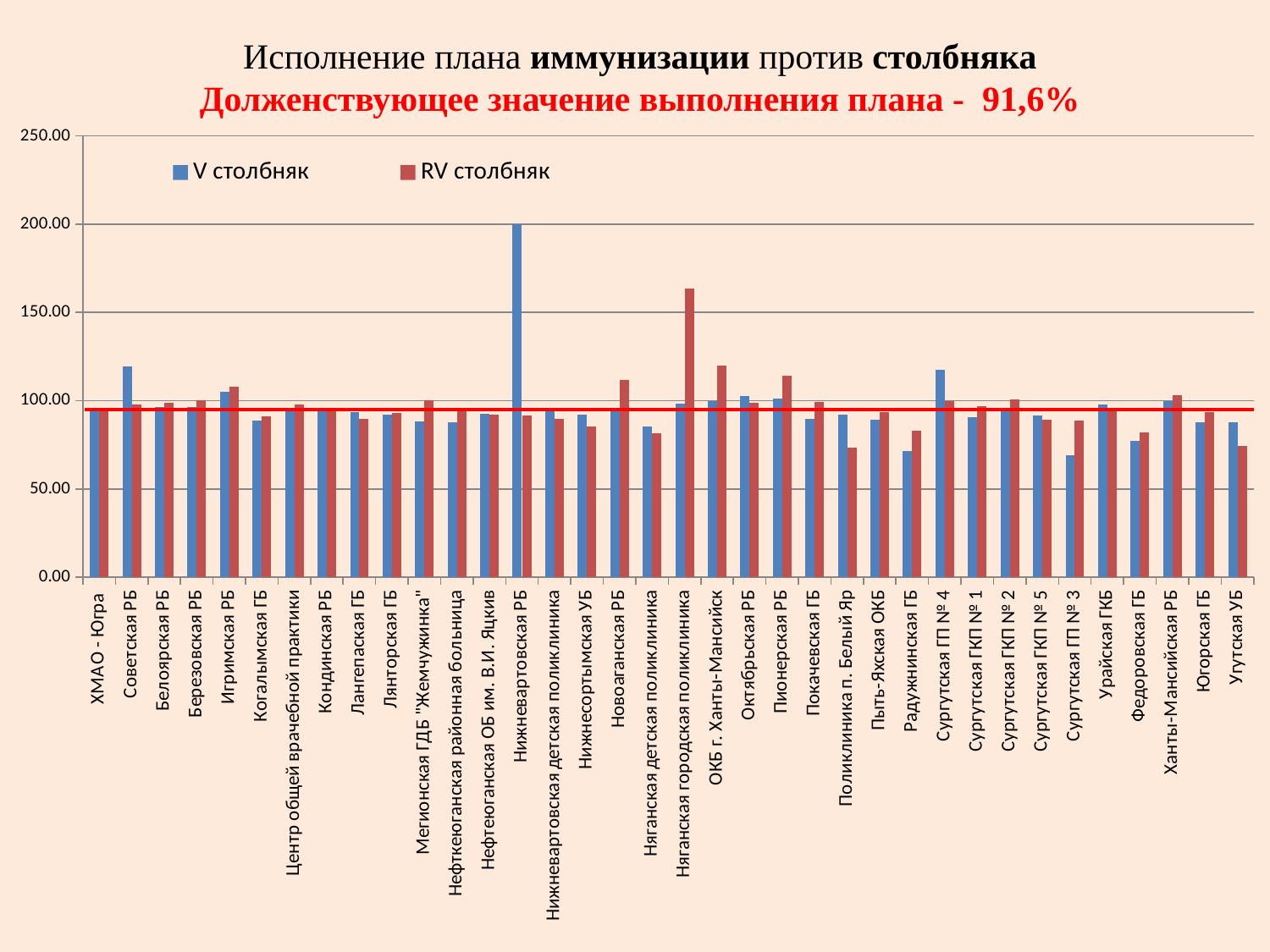
Is the V столбняк value for Нижневартовская РБ greater or less than 150? greater Which category has the highest value for the RV столбняк series? Няганская городская поликлиника How many series does the legend list? 2 Is the V столбняк value for Советская РБ greater or less than 100? greater Is the RV столбняк value for Няганская городская поликлиника greater or less than 150? greater For Пионерская РБ, which series has the larger value, V столбняк or RV столбняк? RV столбняк How many categories (institutions) are shown along the x axis? 36 What kind of chart is shown on the slide? bar chart What target value for plan fulfilment is stated in the chart's subtitle? 91,6% Which category has the highest value for the V столбняк series? Нижневартовская РБ For Советская РБ, which series has the larger value, V столбняк or RV столбняк? V столбняк